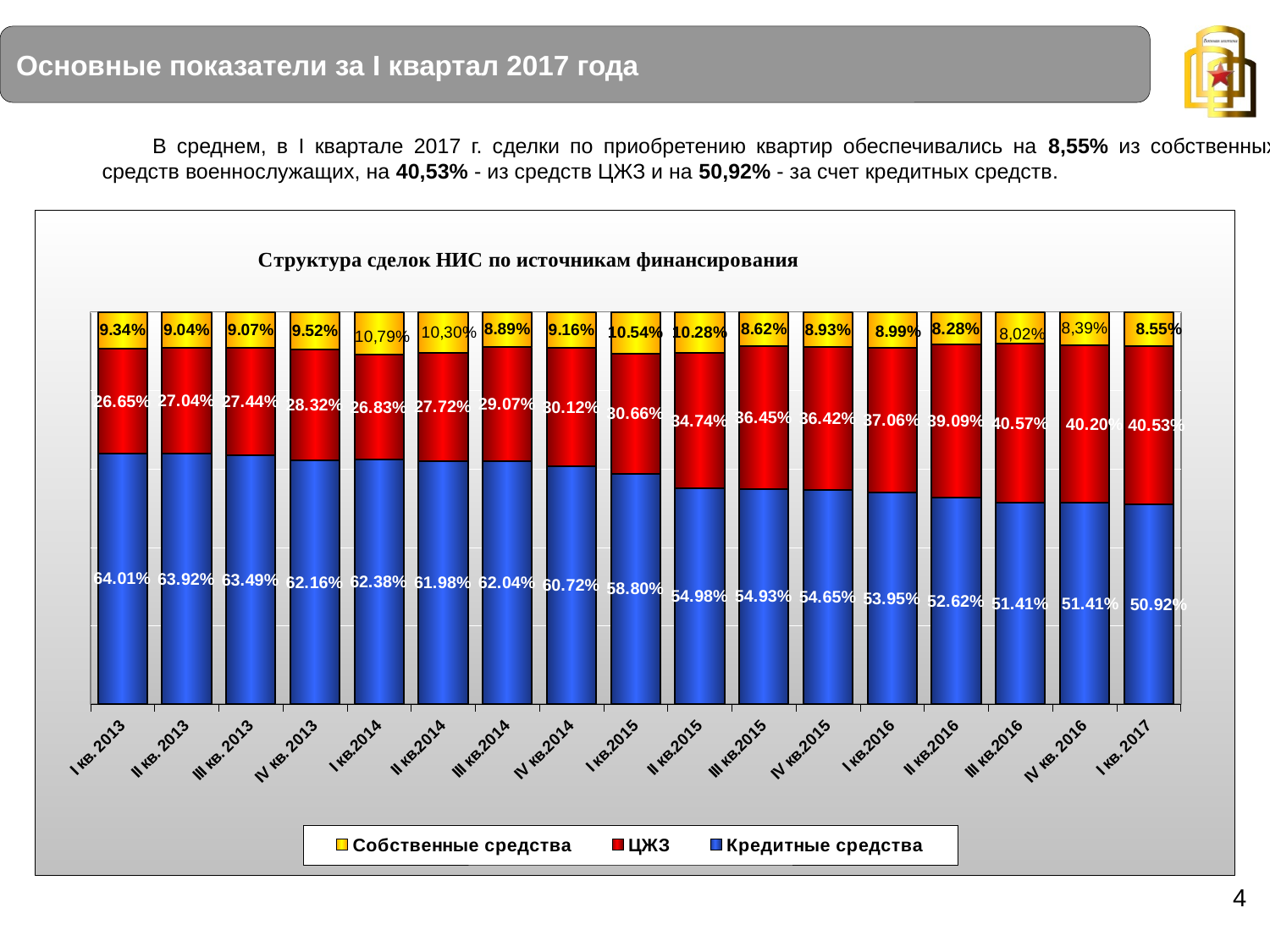
What is the difference between the ЦЖЗ value in I кв. 2017 and in I кв. 2013? 13.88% In which quarter is the share of Кредитные средства lowest? I кв. 2017 Which is larger: the ЦЖЗ value in II кв.2015 or in I кв.2015? II кв.2015 How many series does the legend list? 3 What is the title of the chart? Структура сделок НИС по источникам финансирования In which quarter is the share of Кредитные средства highest? I кв. 2013 Does the share of Кредитные средства rise or fall from I кв. 2013 to I кв. 2017? fall What kind of chart is shown on the slide? stacked bar chart How many quarters are shown on the x axis? 17 What is the value for ЦЖЗ in IV кв.2014? 30.12% What is the value for Кредитные средства in I кв. 2017? 50.92% What is the value for Собственные средства in I кв.2014? 10,79%